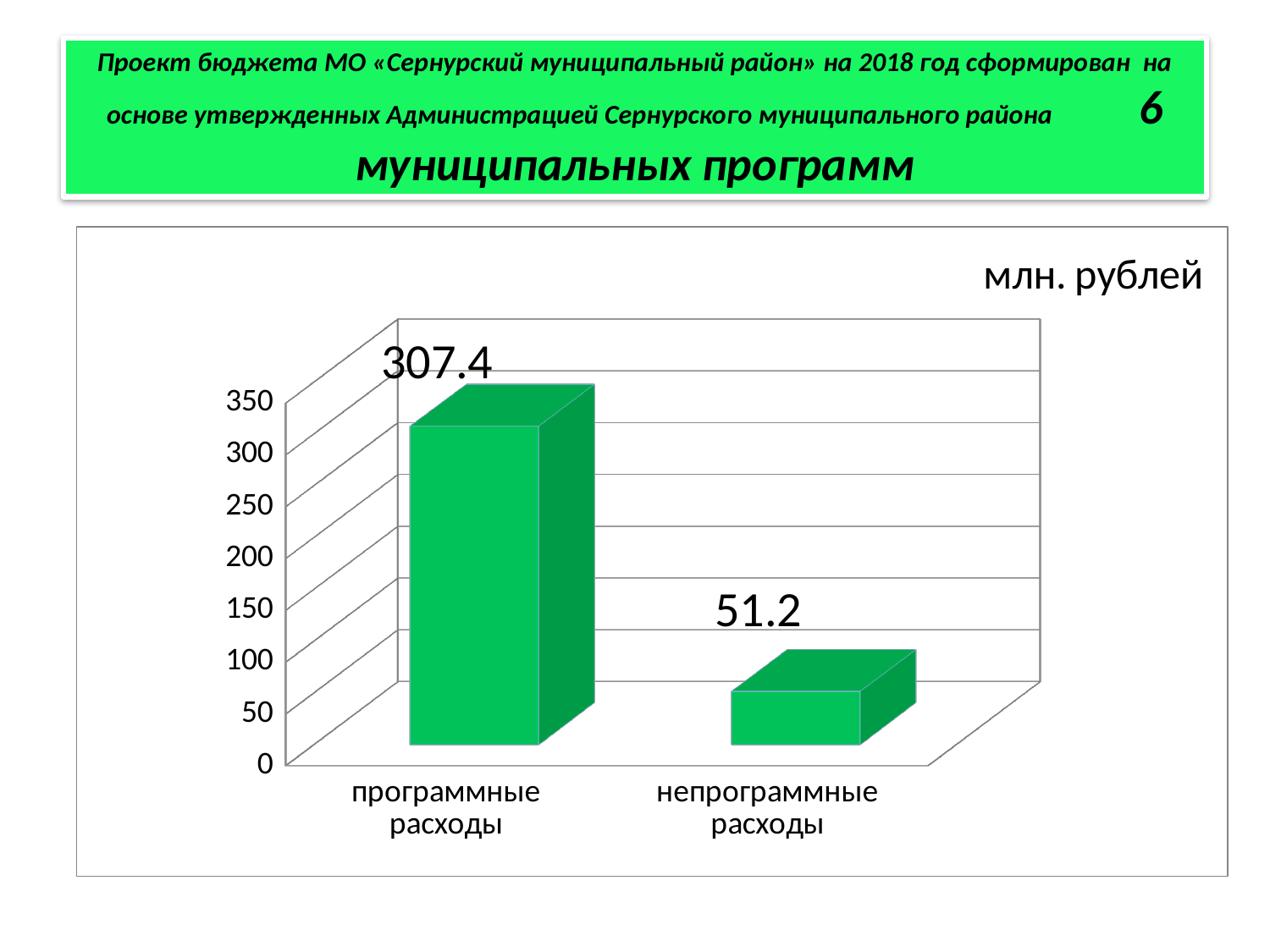
What kind of chart is shown on the slide? bar chart Which category has the lowest value? непрограммные расходы How many categories are shown in the chart? 2 What is the value for программные расходы? 307.4 What is the difference between программные расходы and непрограммные расходы? 256.2 Which is larger, программные расходы or непрограммные расходы? программные расходы What colour are the bars in the chart? green Is the value for программные расходы greater or less than 300? greater What is the value for непрограммные расходы? 51.2 What unit is indicated in the top right corner of the chart? млн. рублей Is the value for непрограммные расходы greater or less than 100? less Which category has the highest value? программные расходы